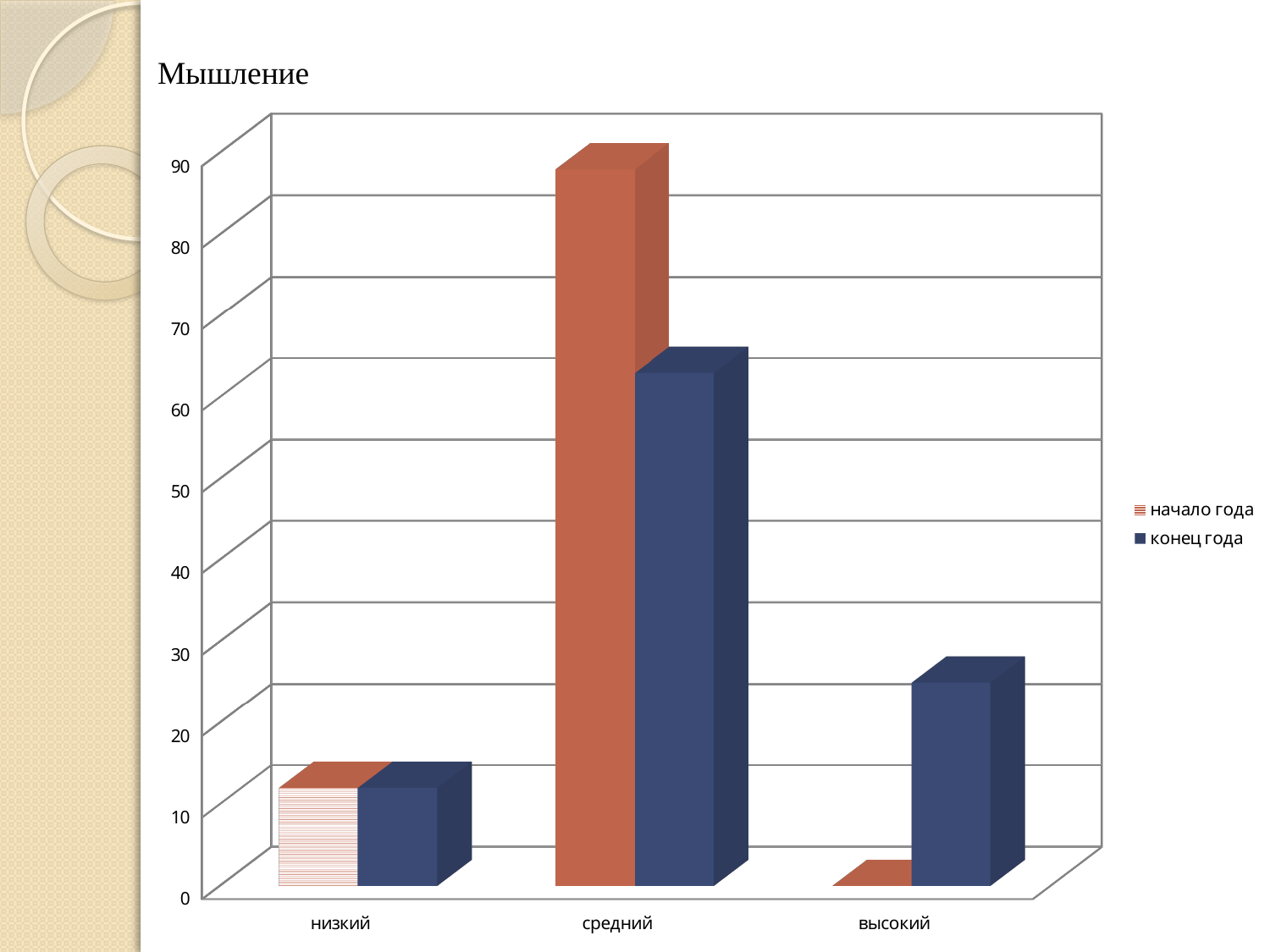
For высокий, which series has the larger value, начало года or конец года? конец года Which category has the highest value for начало года? средний How many series does the legend list? 2 Which category has the lowest value for начало года? высокий What kind of chart is shown on the slide? bar chart Which category has the lowest value for конец года? низкий What is the title of the chart? Мышление How many categories are shown on the x axis? 3 For средний, which series has the larger value, начало года or конец года? начало года Which category has the highest value for конец года? средний Is the value for высокий in конец года greater or less than 30? less Is the value for средний in начало года greater or less than 80? greater